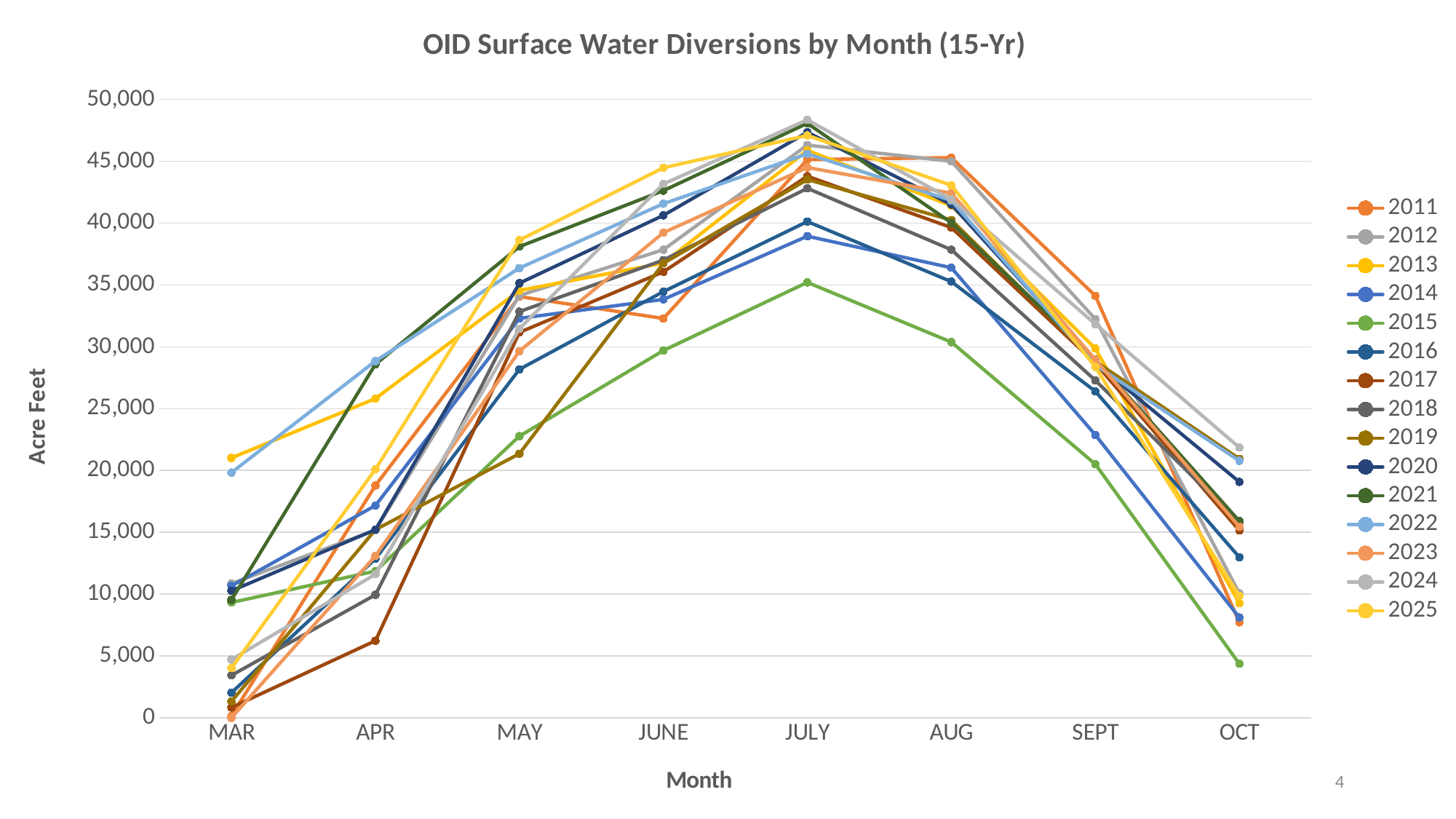
Is the value for 2015 in JULY greater or less than 30,000? greater Is the value for 2017 in APR greater or less than 10,000? less How many series does the legend list? 15 What is the label on the vertical axis? Acre Feet How many months are shown along the x axis? 8 What is the title of the chart? OID Surface Water Diversions by Month (15-Yr) Which series has the lowest value in OCT? 2015 In which month does the 2015 series reach its highest value? JULY What kind of chart is shown on the slide? Line chart Is the value for 2024 in JULY greater or less than 45,000? greater Which series has the lowest value in JULY? 2015 Which is larger in JULY, the value for 2015 or the value for 2024? 2024